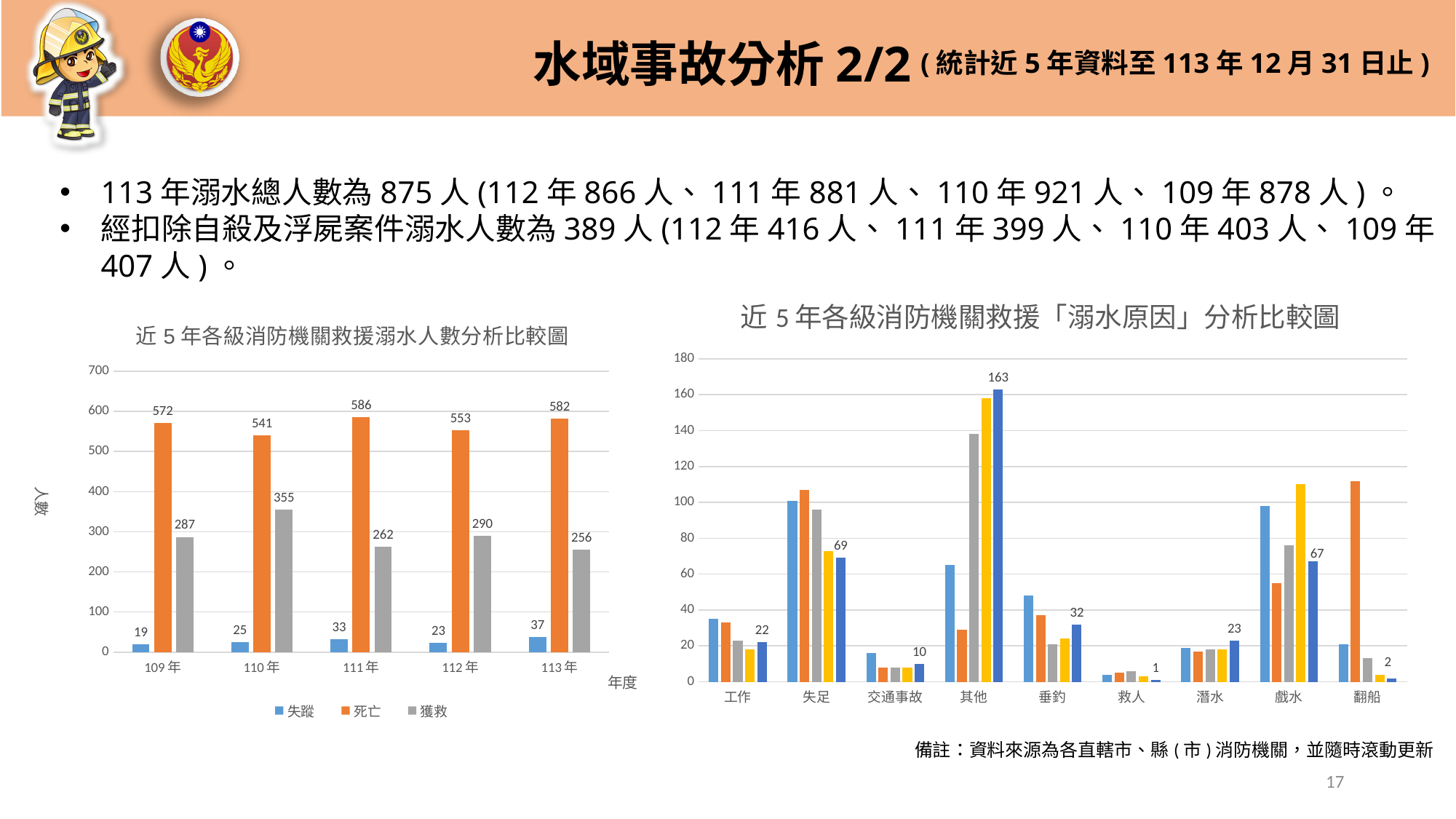
In the left chart (近5年各級消防機關救援溺水人數分析比較圖), which year has the lowest 死亡 value? 110年 In the left chart (近5年各級消防機關救援溺水人數分析比較圖), which year has the highest 失蹤 value? 113年 In the left chart (近5年各級消防機關救援溺水人數分析比較圖), what is the difference between the 死亡 value and the 獲救 value in 113年? 326 In the right chart (近5年各級消防機關救援「溺水原因」分析比較圖), how many categories are shown on the x axis? 9 In the left chart (近5年各級消防機關救援溺水人數分析比較圖), what is the value for 獲救 in 110年? 355 In the left chart (近5年各級消防機關救援溺水人數分析比較圖), how many series does the legend list? 3 In the right chart (近5年各級消防機關救援「溺水原因」分析比較圖), which category has the highest labelled dark blue bar value? 其他 In the right chart (近5年各級消防機關救援「溺水原因」分析比較圖), what is the labelled value for the dark blue bar in the 其他 category? 163 In the right chart (近5年各級消防機關救援「溺水原因」分析比較圖), is the value of the orange bar for 翻船 greater or less than 100? greater In the right chart (近5年各級消防機關救援「溺水原因」分析比較圖), what is the labelled value for the dark blue bar in the 戲水 category? 67 In the left chart (近5年各級消防機關救援溺水人數分析比較圖), what kind of chart is it? Bar chart In the left chart (近5年各級消防機關救援溺水人數分析比較圖), what is the value for 死亡 in 111年? 586